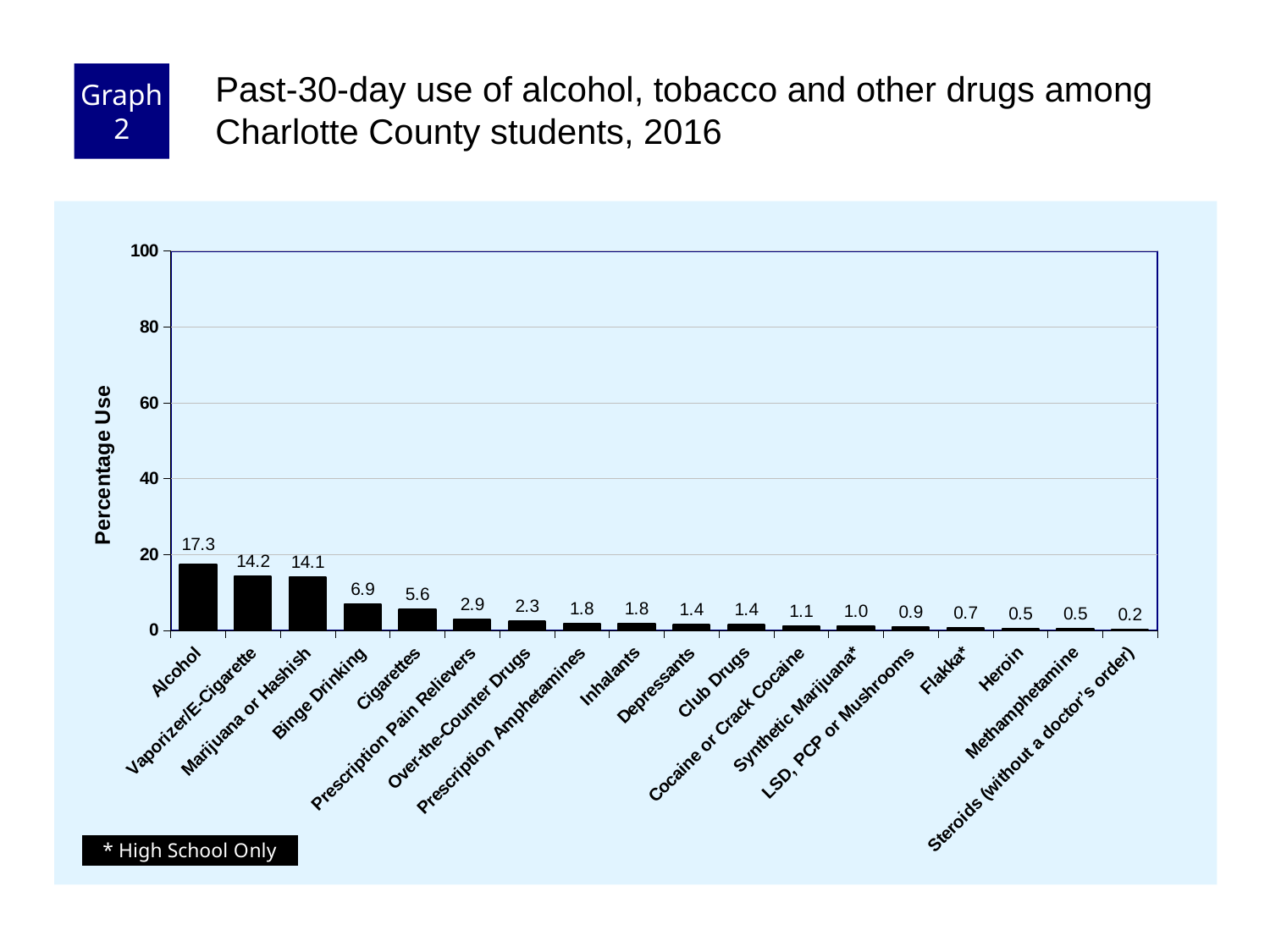
Is the value for Alcohol greater or less than 20? less How many categories are shown on the x axis? 18 What kind of chart is shown on the slide? Bar chart What is the percentage use for Binge Drinking? 6.9 What is the percentage use for Alcohol? 17.3 What is the percentage use for Cigarettes? 5.6 Which category has the lowest percentage use? Steroids (without a doctor's order) Which category has the highest percentage use? Alcohol Which has a higher percentage use, Binge Drinking or Cigarettes? Binge Drinking What is the percentage use for Heroin? 0.5 What is the label on the y axis? Percentage Use What is the difference in percentage use between Alcohol and Vaporizer/E-Cigarette? 3.1